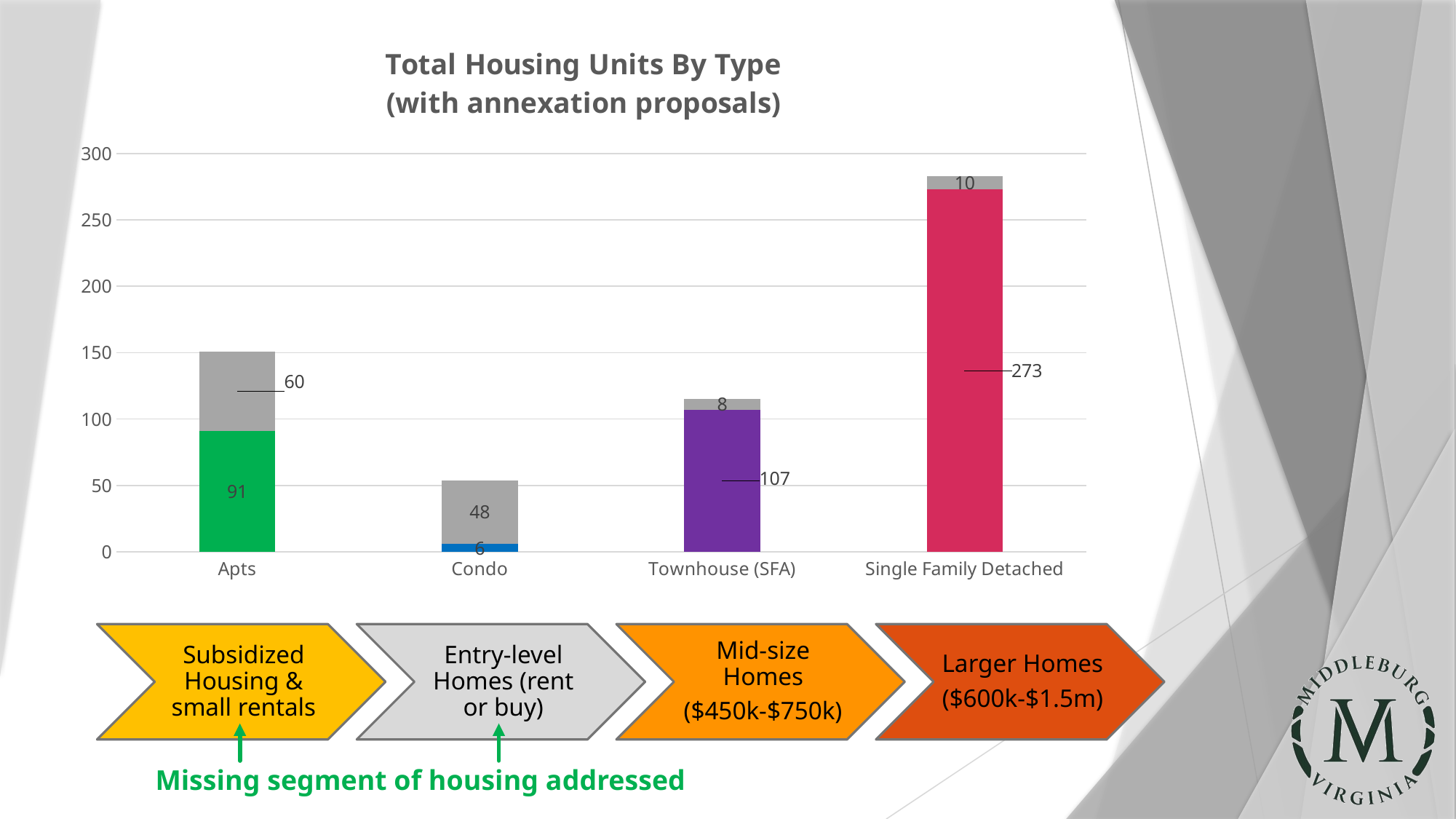
What is the value of the green (bottom) segment of the Apts bar? 91 What is the value of the blue (bottom) segment of the Condo bar? 6 What is the total of the stacked bar for Apts? 151 What is the total of the stacked bar for Single Family Detached? 283 What is the value of the gray segment of the Townhouse (SFA) bar? 8 Which category has the tallest stacked bar? Single Family Detached What is the difference between the bottom segment of the Single Family Detached bar (273) and the bottom segment of the Townhouse (SFA) bar (107)? 166 What is the title of the chart? Total Housing Units By Type (with annexation proposals) What is the value of the pink (bottom) segment of the Single Family Detached bar? 273 How many housing type categories are shown on the x axis of the chart? 4 What is the value of the gray (top) segment of the Apts bar? 60 What kind of chart is shown on the slide? Stacked bar chart